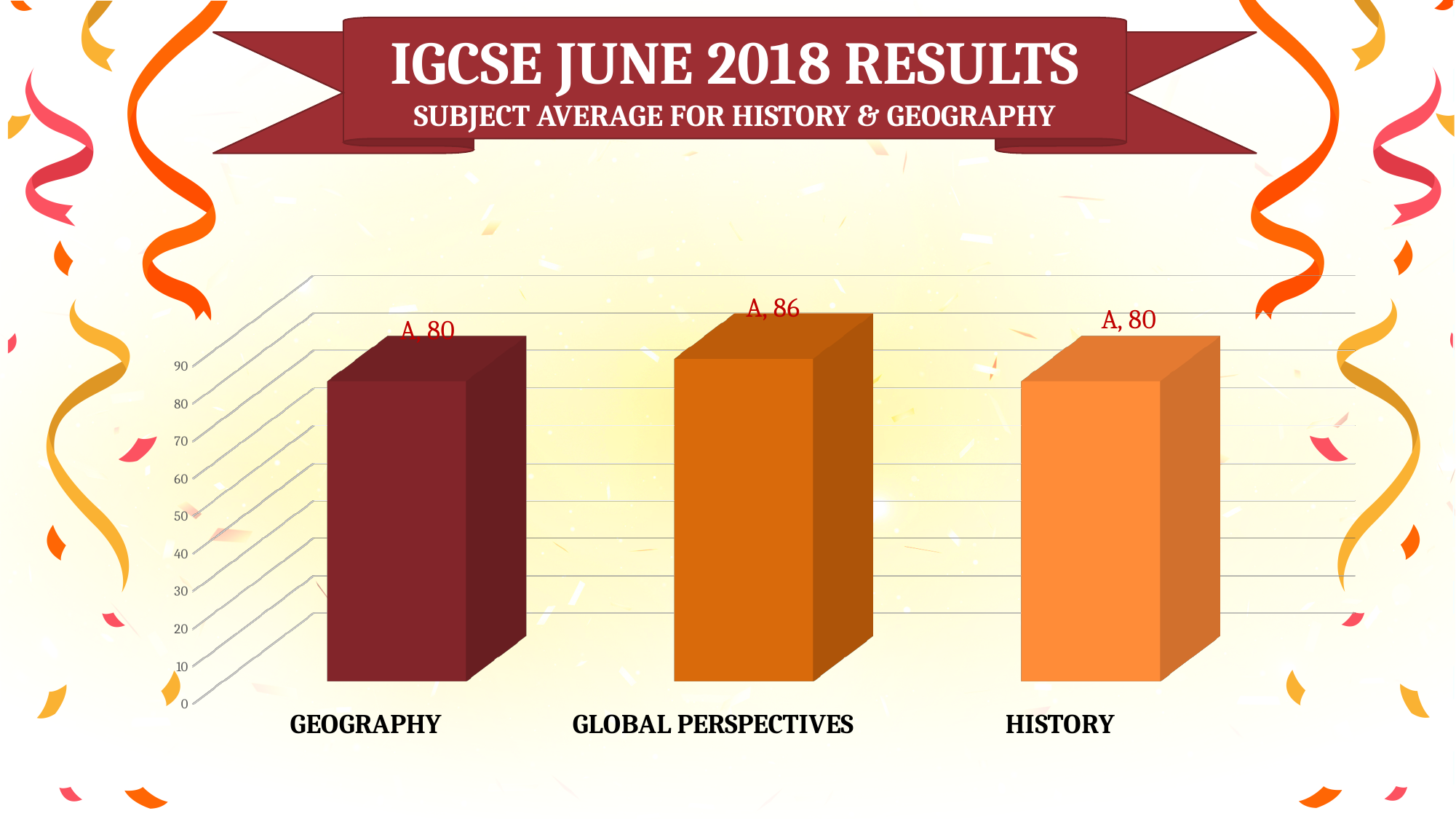
What is the difference between the Global Perspectives average and the History average? 6 What is the subtitle shown below the main title? SUBJECT AVERAGE FOR HISTORY & GEOGRAPHY How many subjects are shown in the chart? 3 Which is larger, the average for Global Perspectives or the average for Geography? Global Perspectives What is the data label shown for Geography? A, 80 What is the data label shown for History? A, 80 What is the data label shown for Global Perspectives? A, 86 Is the value for History greater or less than 70? greater What is the main title shown on the banner above the chart? IGCSE JUNE 2018 RESULTS Which subject has the highest average? Global Perspectives What kind of chart is shown on the slide? Bar chart Is the value for Global Perspectives greater or less than 90? less